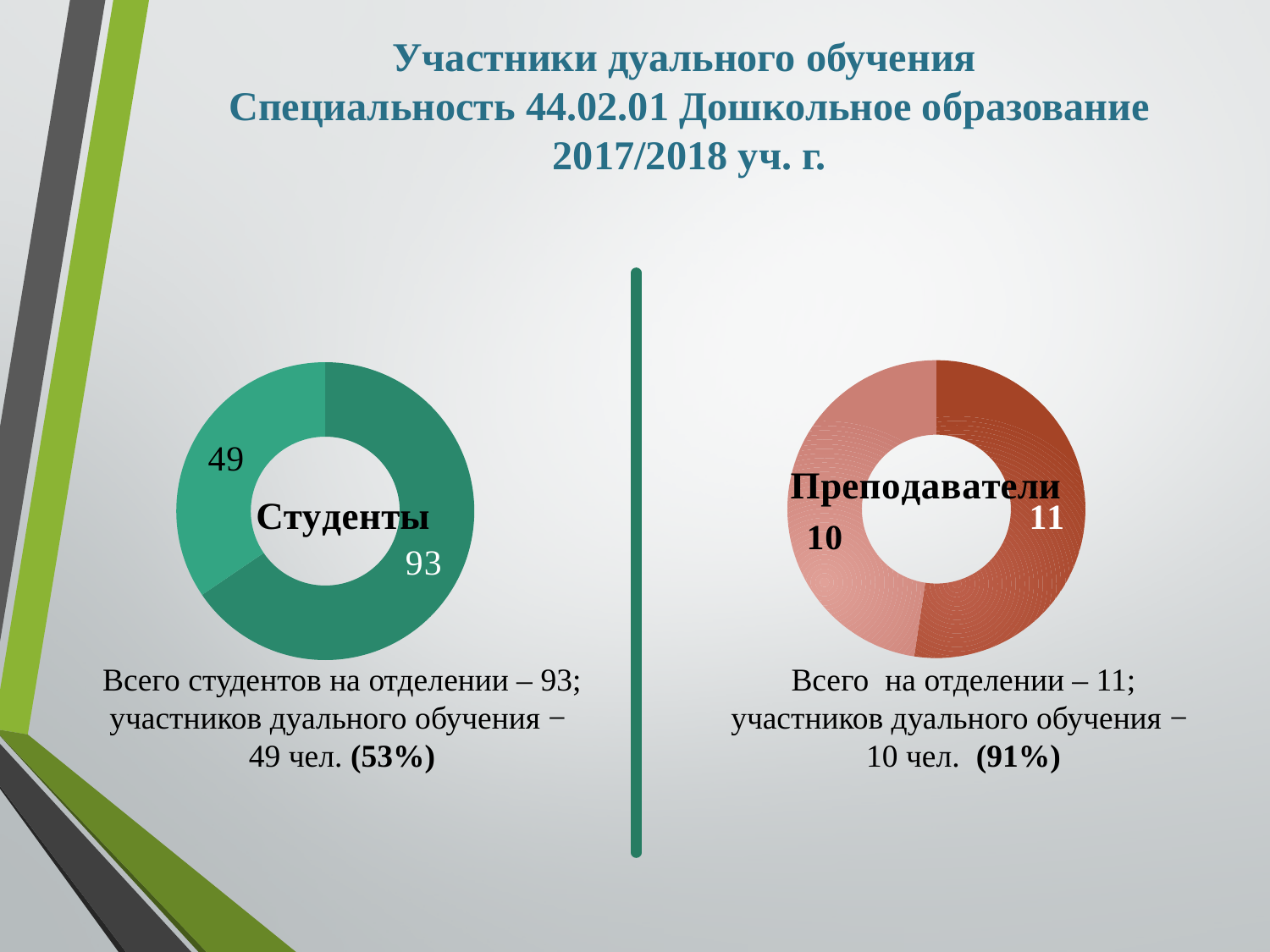
In the left chart "Студенты", which value is larger, 49 or 93? 93 How many slices does the left chart "Студенты" have? 2 In the left chart "Студенты", what is the smaller value shown? 49 In the left chart "Студенты", what is the larger value shown? 93 In the right chart "Преподаватели", what is the difference between the two values shown (11 and 10)? 1 How many slices does the right chart "Преподаватели" have? 2 What type of chart is the left chart labelled "Студенты"? doughnut chart In the right chart "Преподаватели", what is the smaller value shown? 10 What colour are the slices of the left chart "Студенты"? green What label is printed in the centre of the right chart? Преподаватели In the right chart "Преподаватели", what is the larger value shown? 11 In the left chart "Студенты", what is the difference between the two values shown (93 and 49)? 44